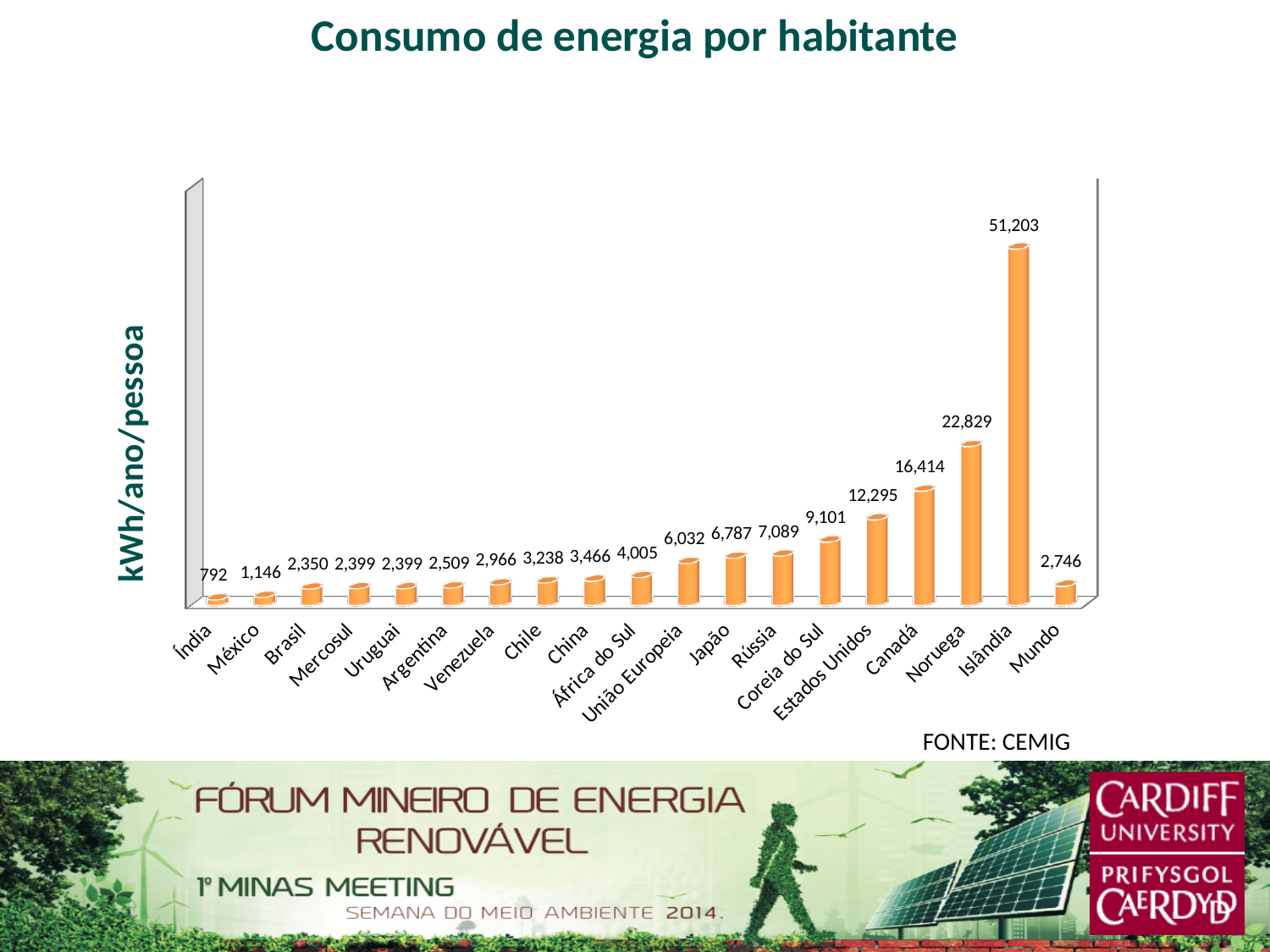
What is the difference between the values for Canadá and Estados Unidos? 4,119 Which category has the highest energy consumption per inhabitant? Islândia Which has a larger value, Japão or Rússia? Rússia What is the energy consumption per inhabitant for Brasil? 2,350 Which category has the lowest energy consumption per inhabitant? Índia What is the value for Mundo? 2,746 What is the label on the vertical axis? kWh/ano/pessoa How many categories are shown on the x axis? 19 What value is shown for Estados Unidos? 12,295 What is the difference between the values for Islândia and Noruega? 28,374 What is the value shown for Coreia do Sul? 9,101 What kind of chart is shown on the slide? Bar chart